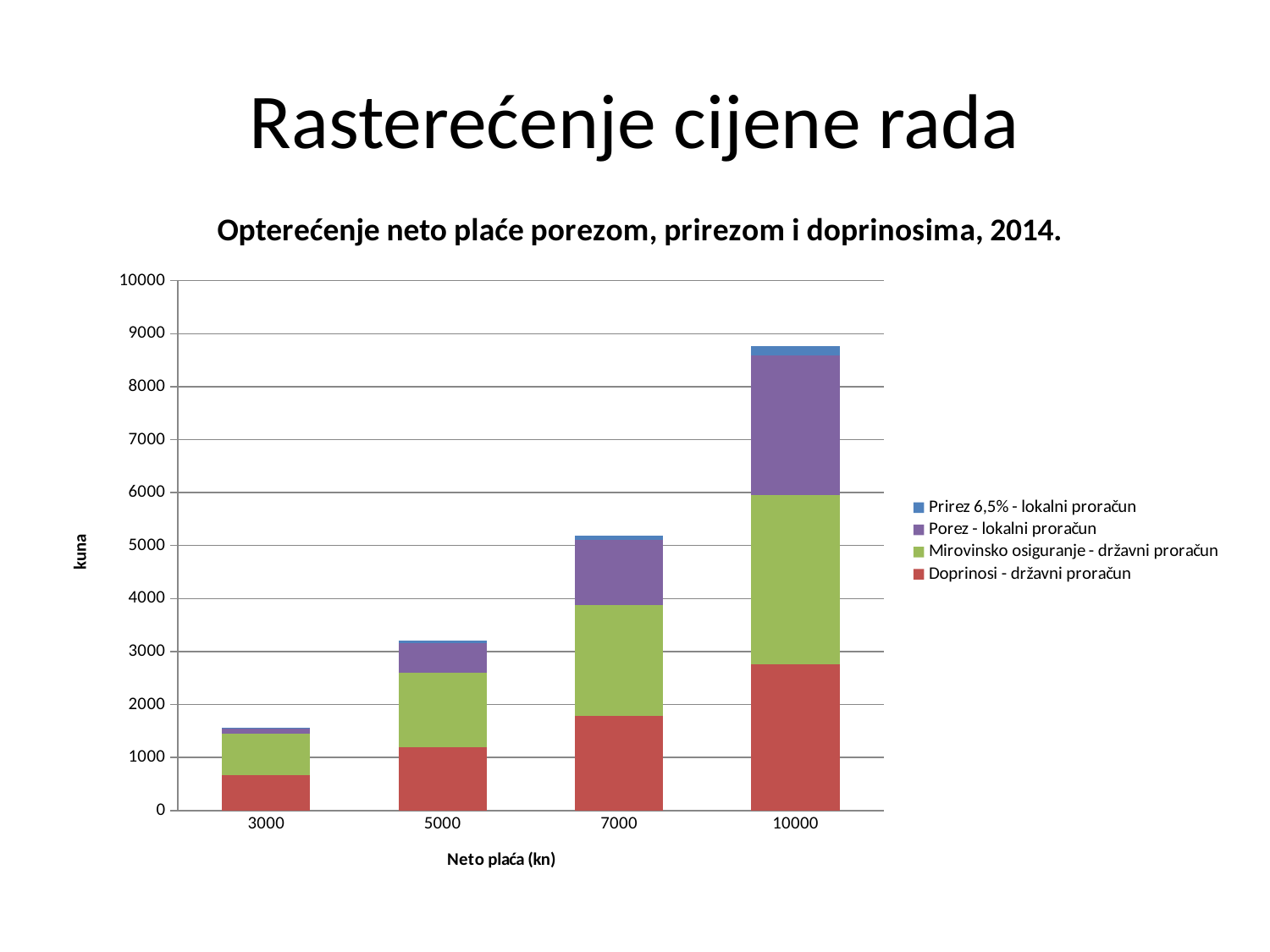
Is the Doprinosi - državni proračun value for the 10000 net salary bar greater or less than 2000? greater What is the title of the chart? Opterećenje neto plaće porezom, prirezom i doprinosima, 2014. Is the total stacked value for the 10000 net salary bar greater or less than 8000? greater What kind of chart is shown on the slide? Stacked bar chart Which net salary category has the shortest stacked bar? 3000 What is the label of the x axis? Neto plaća (kn) How many net salary categories are shown on the x axis? 4 How many series does the legend list? 4 Is the total stacked value for the 3000 net salary bar greater or less than 2000? less Do the total bar heights rise or fall as net salary increases along the x axis? Rise Which net salary category has the tallest stacked bar? 10000